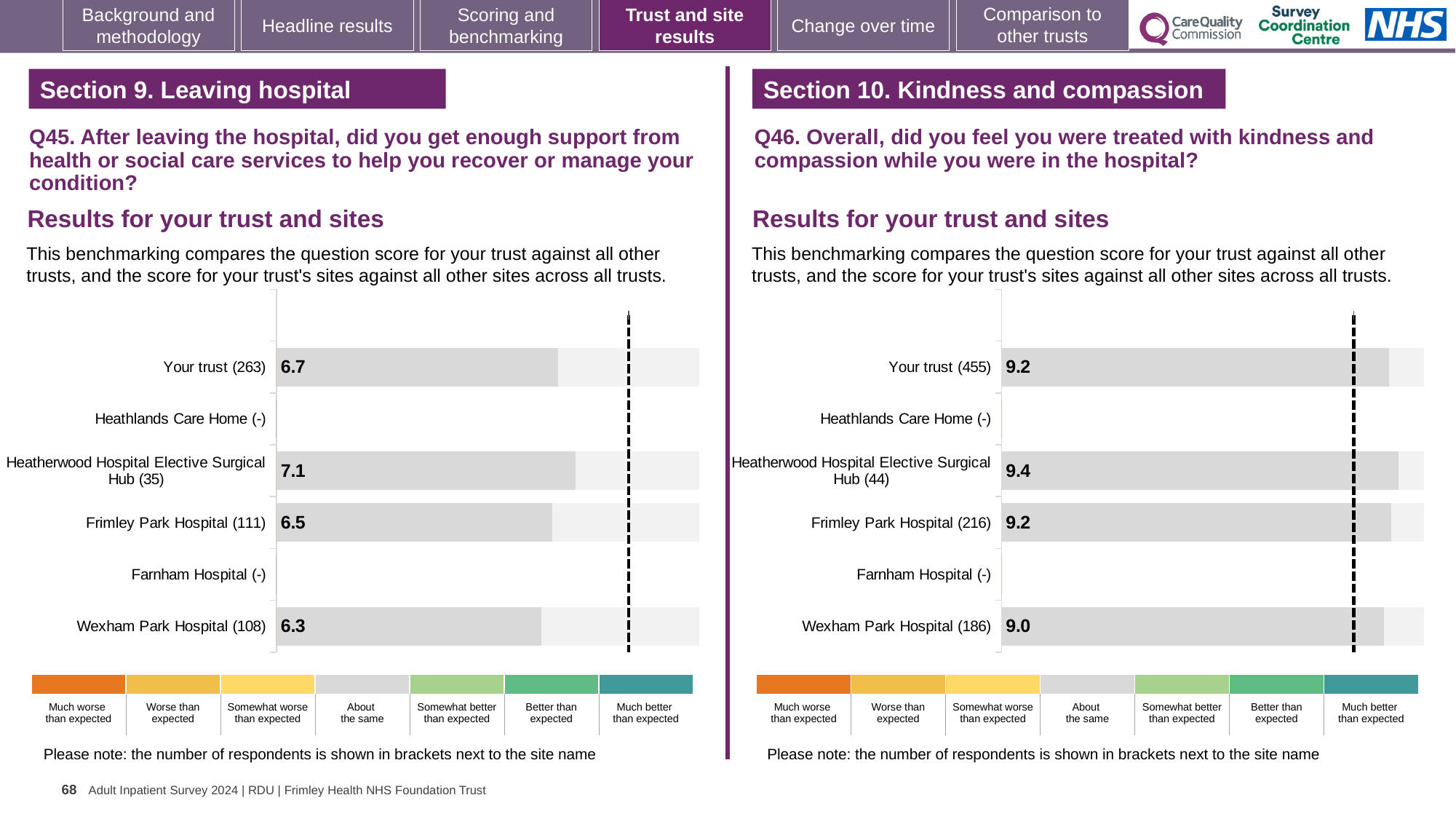
In the Q46 chart on the right, what is the difference between the scores for Your trust (455) and Wexham Park Hospital (186)? 0.2 In the Q45 chart on the left, which site has the lowest score? Wexham Park Hospital (108) In the Q45 chart on the left, what is the difference between the scores for Heatherwood Hospital Elective Surgical Hub (35) and Frimley Park Hospital (111)? 0.6 In the Q46 chart on the right, is the score for Your trust (455) or Heatherwood Hospital Elective Surgical Hub (44) larger? Heatherwood Hospital Elective Surgical Hub (44) In the Q46 chart on the right, what is the score for Heatherwood Hospital Elective Surgical Hub (44)? 9.4 In the Q46 chart on the right, which site has the lowest score? Wexham Park Hospital (186) In the Q45 chart on the left, what is the score for Your trust (263)? 6.7 In the Q45 chart on the left, what is the score for Wexham Park Hospital (108)? 6.3 In the Q45 chart on the left, how many bars have a score printed? 4 In the Q46 chart on the right, what is the score for Wexham Park Hospital (186)? 9.0 In the Q45 chart on the left, which site has the highest score? Heatherwood Hospital Elective Surgical Hub (35) What kind of chart is used for the Q45 results on the left? Bar chart